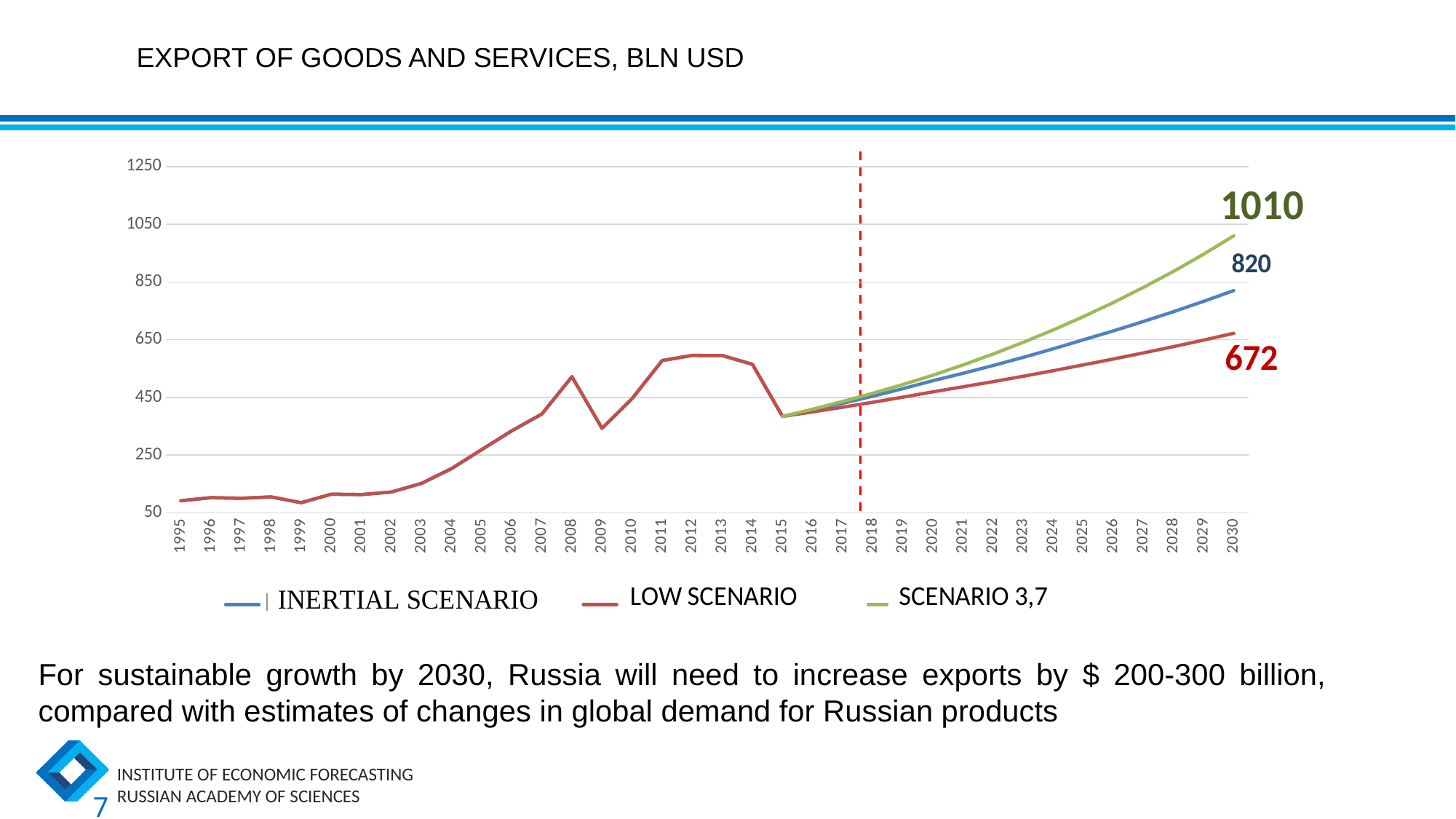
What kind of chart is shown on the slide? line chart What is the difference between the 2030 values of Scenario 3,7 and the Low Scenario? 338 Is the value for 2009 greater or less than 450? less How many series does the legend list? 3 What is the value for the Low Scenario in 2030? 672 Which scenario has the lowest value in 2030? Low Scenario Which scenario has the highest value in 2030? Scenario 3,7 In 2030, which is larger: the Inertial Scenario or the Low Scenario? Inertial Scenario What is the value for the Inertial Scenario in 2030? 820 What is the difference between the 2030 values of the Inertial Scenario and the Low Scenario? 148 Is the value for 2008 greater or less than 450? greater What is the value for Scenario 3,7 in 2030? 1010